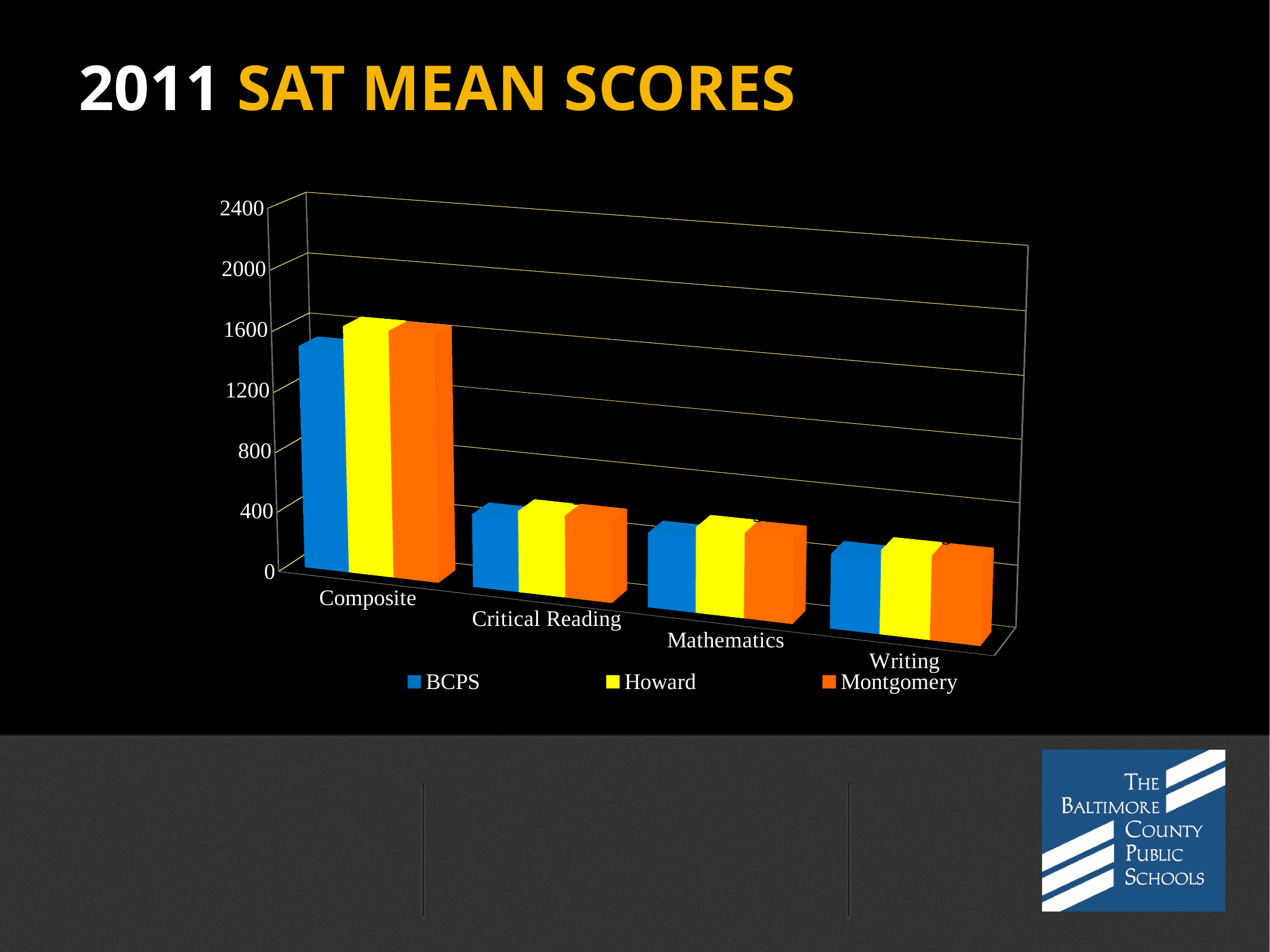
For BCPS, which is larger: the Composite value or the Writing value? Composite Which colour represents the Montgomery series in the chart? orange In the Composite category, which is larger: the BCPS value or the Howard value? Howard Which category has the highest bars for all three series? Composite Which series has the lowest bar in the Composite category? BCPS Is the BCPS value for Critical Reading greater or less than 800? less Is the Montgomery value for Writing greater or less than 800? less How many series does the chart's legend list? 3 Is the BCPS value for Composite greater or less than 1200? greater How many categories are shown on the x axis of the chart? 4 What kind of chart is shown on the slide? bar chart